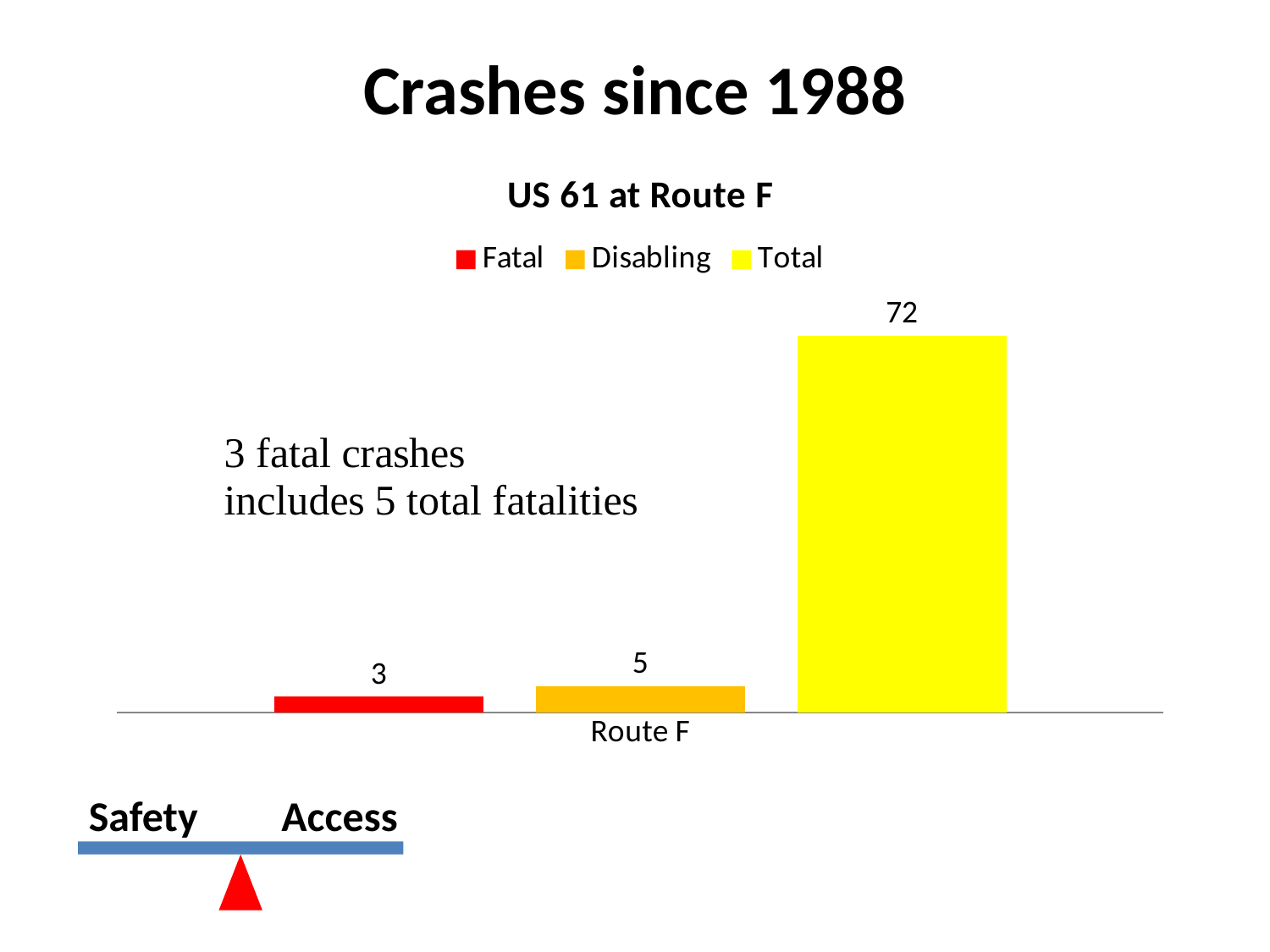
What is the value of the Disabling series for Route F? 5 How many series does the legend list? 3 What is the value of the Fatal series for Route F? 3 What is the difference between the Disabling and Fatal values for Route F? 2 What kind of chart is shown on the slide? Bar chart What is the title of the chart? US 61 at Route F Which series has the highest value for Route F? Total How many categories are shown on the x axis? 1 Which series has the lowest value for Route F? Fatal What is the value of the Total series for Route F? 72 Which is larger for Route F, the Disabling value or the Fatal value? Disabling What is the difference between the Total and Disabling values for Route F? 67